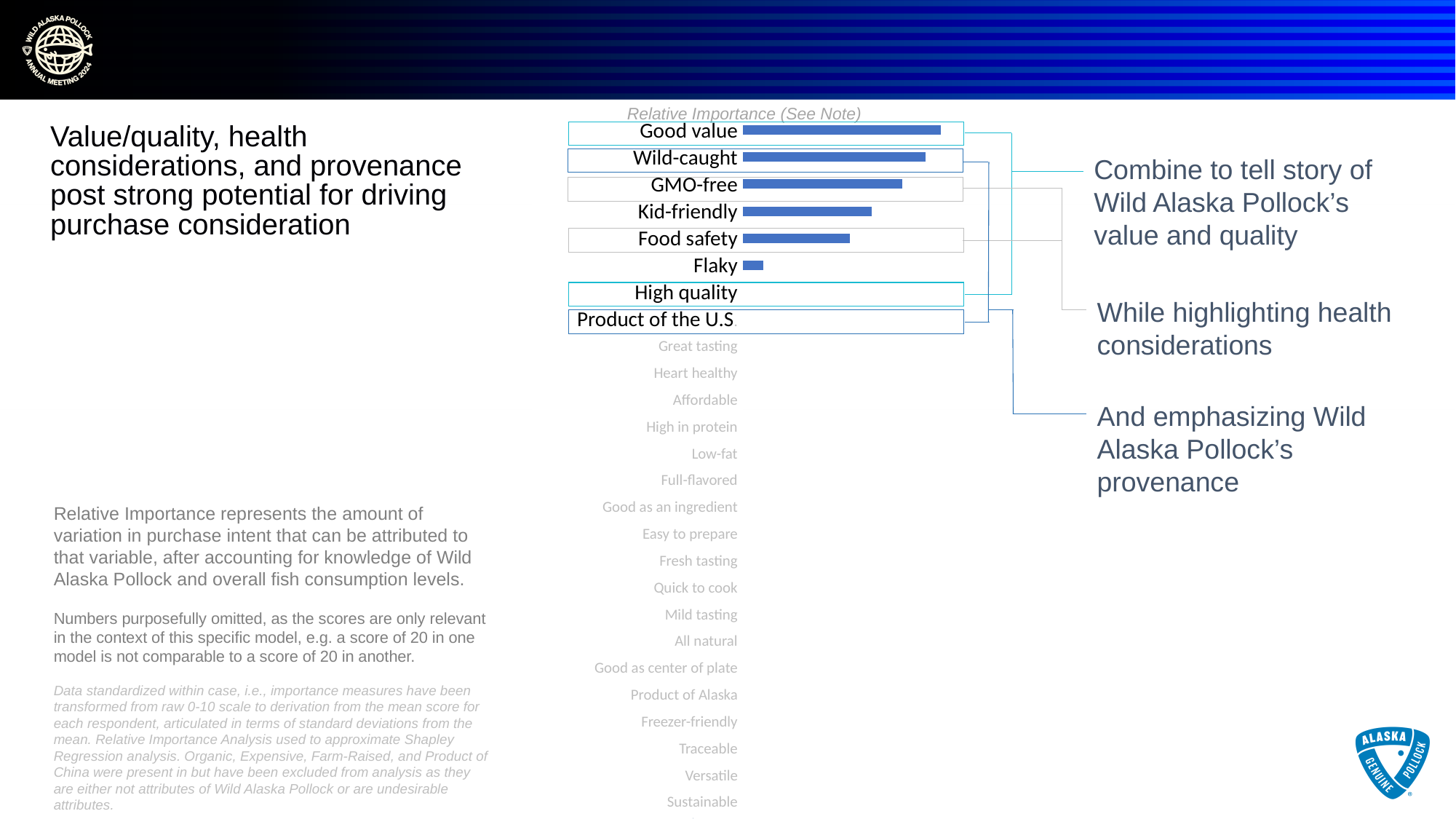
Among the attributes with a visible bar, which has the shortest bar? Flaky Which has the longer bar, Food safety or Flaky? Food safety How many attributes in the chart have a visible bar? 6 Which attribute has the longest bar in the Relative Importance chart? Good value Which has the longer bar, GMO-free or Food safety? GMO-free Which has the longer bar, Good value or Kid-friendly? Good value What kind of chart is shown on the slide? Bar chart Which attribute is listed at the top of the chart? Good value What is the title shown above the chart? Relative Importance (See Note)